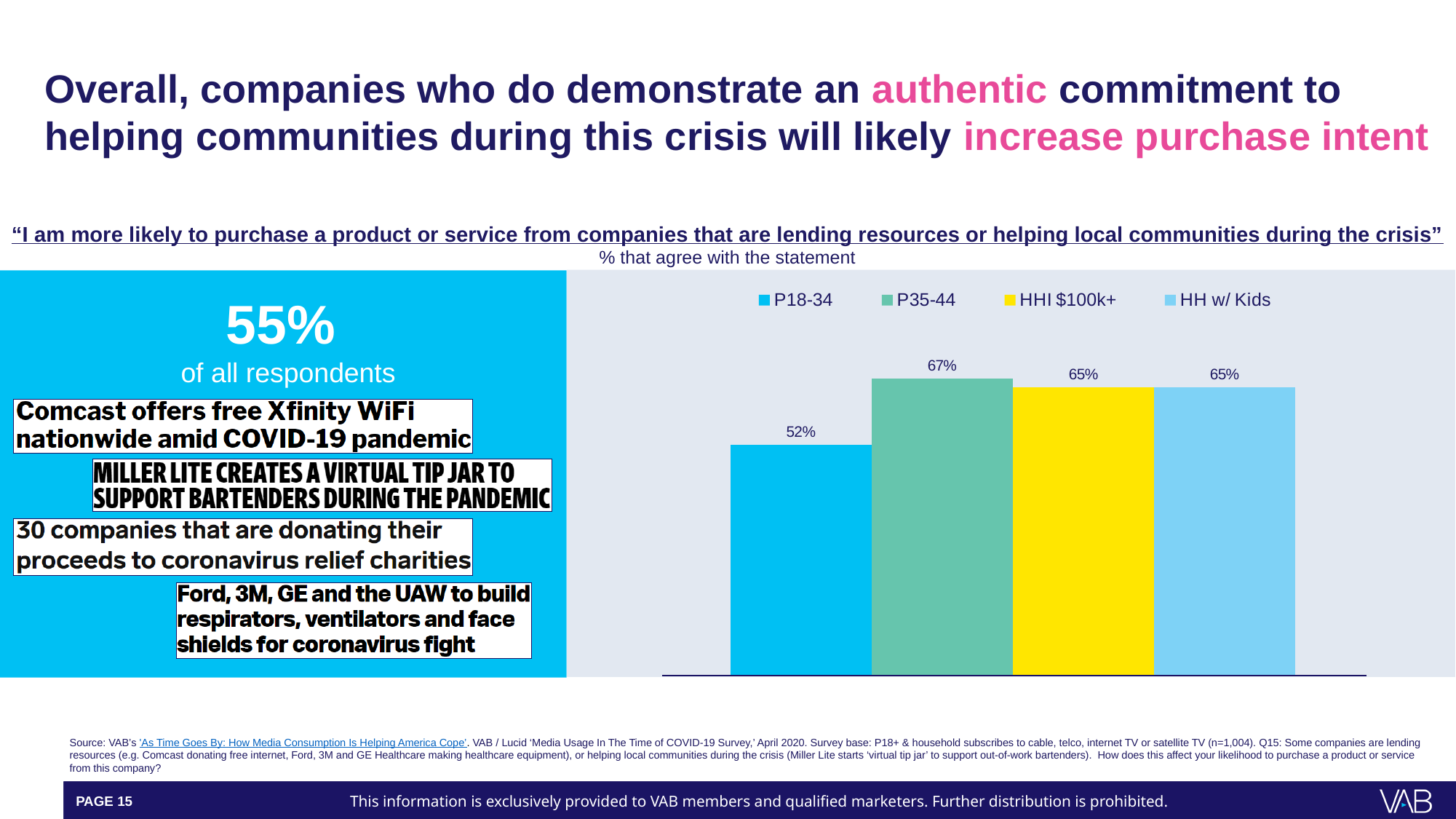
Which is larger, the value for P18-34 or the value for HHI $100k+? HHI $100k+ What percentage of P35-44 respondents agree with the statement? 67% What is the difference in percentage points between P35-44 and P18-34? 15 What percentage of all respondents agree with the statement, according to the blue panel? 55% What kind of chart is shown on the slide? Bar chart What is the value shown for HH w/ Kids? 65% Which group has the highest percentage agreeing with the statement? P35-44 Which group has the lowest percentage agreeing with the statement? P18-34 What is the value shown for HHI $100k+? 65% What colour is the bar for HHI $100k+? Yellow What percentage of P18-34 respondents agree with the statement? 52% How many series does the legend list? 4